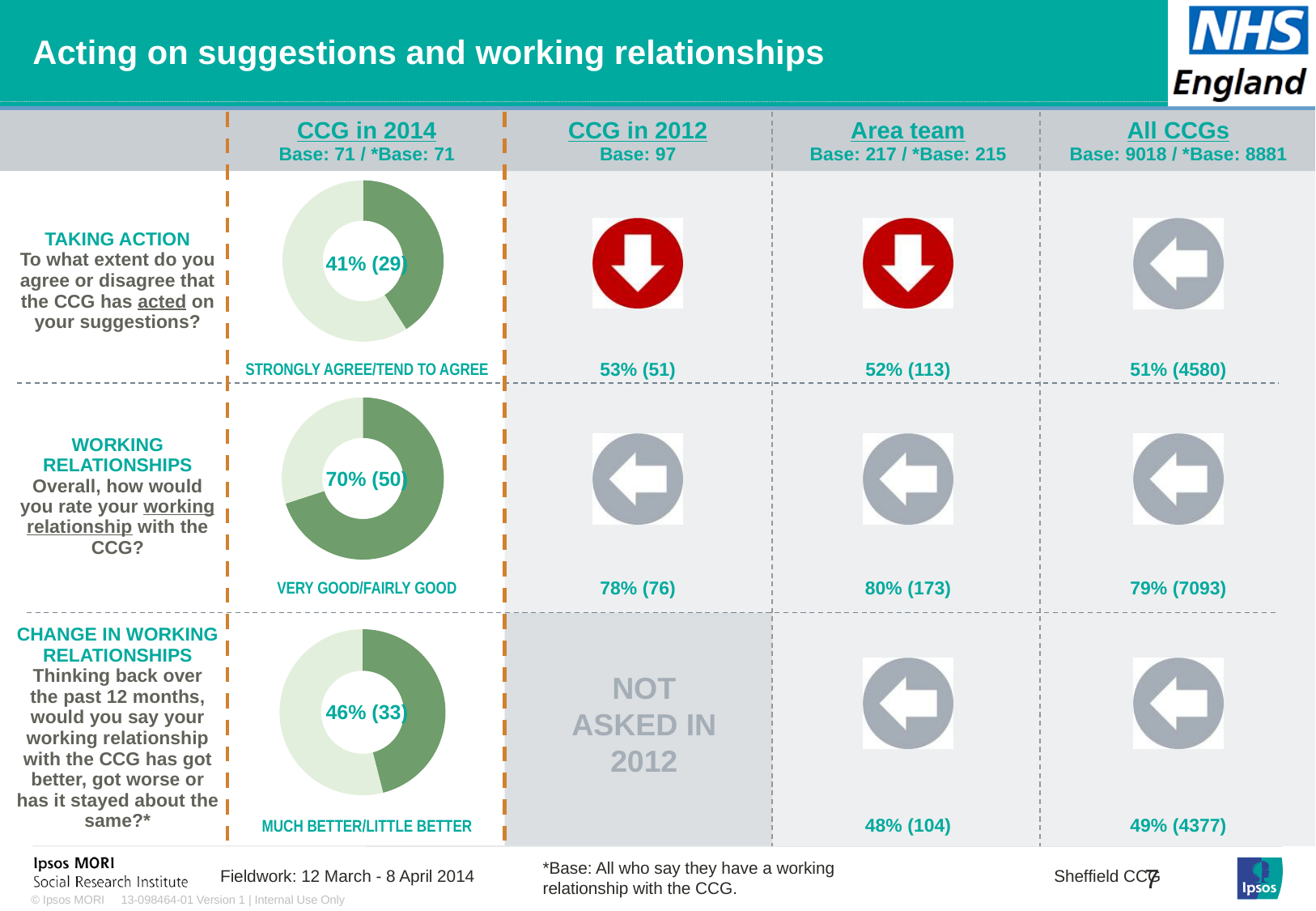
In the 'Working Relationships' donut chart for CCG in 2014, what percentage rate their working relationship as very good or fairly good? 70% (50) In the 'Taking Action' donut chart for CCG in 2014, what percentage strongly agree or tend to agree that the CCG has acted on their suggestions? 41% (29) What is the base size shown for the 'CCG in 2014' column? Base: 71 / *Base: 71 In the 'Change in Working Relationships' donut chart for CCG in 2014, what percentage say the relationship has got much better or a little better? 46% (33) Which is larger: the CCG in 2014 'Taking Action' percentage or the CCG in 2012 'Taking Action' percentage? CCG in 2012 (53%) What type of chart is used in the 'CCG in 2014' column for each question? Donut (pie) chart Is the percentage in the 'Taking Action' donut chart for CCG in 2014 greater or less than 50%? less How many donut charts are shown on the slide? 3 Which of the three CCG in 2014 donut charts shows the lowest percentage? Taking Action (41%) What is the difference in percentage points between the CCG in 2014 'Working Relationships' donut (70%) and the All CCGs figure for the same question (79%)? 9 percentage points Which of the three CCG in 2014 donut charts shows the highest percentage? Working Relationships (70%) What label appears beneath the 'Change in Working Relationships' donut chart for CCG in 2014? MUCH BETTER/LITTLE BETTER